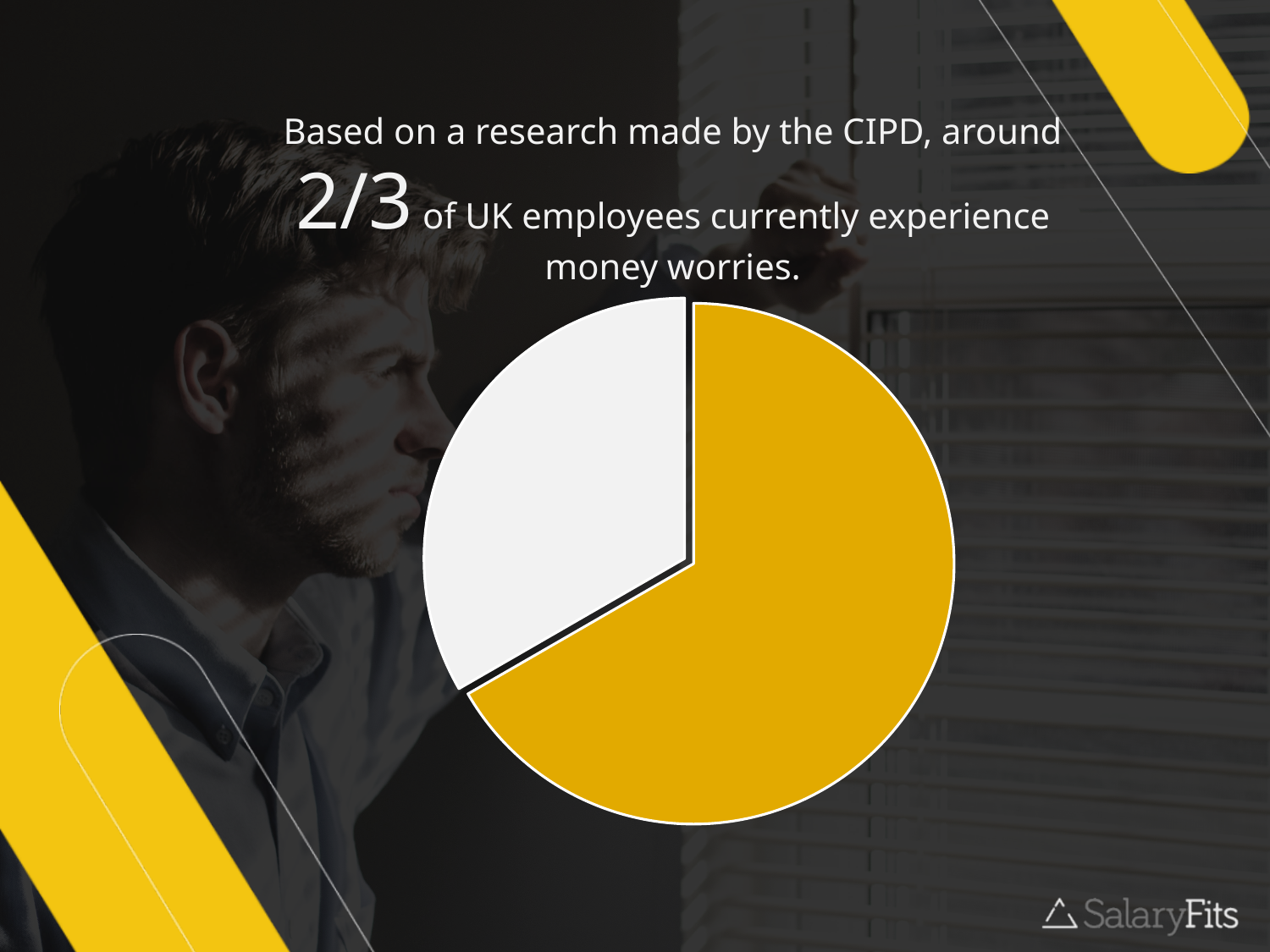
Which slice of the pie chart is larger, the yellow one or the white one? the yellow one According to the slide text, what fraction of UK employees currently experience money worries, as represented by the larger slice of the pie? 2/3 Which organisation's research is cited in the text above the pie chart? the CIPD Does the yellow slice of the pie chart cover more or less than half of the pie? more What kind of chart is shown on the slide? pie chart How many slices does the pie chart have? 2 Which slice of the pie chart is the smallest? the white slice What colour is the larger slice of the pie chart? yellow